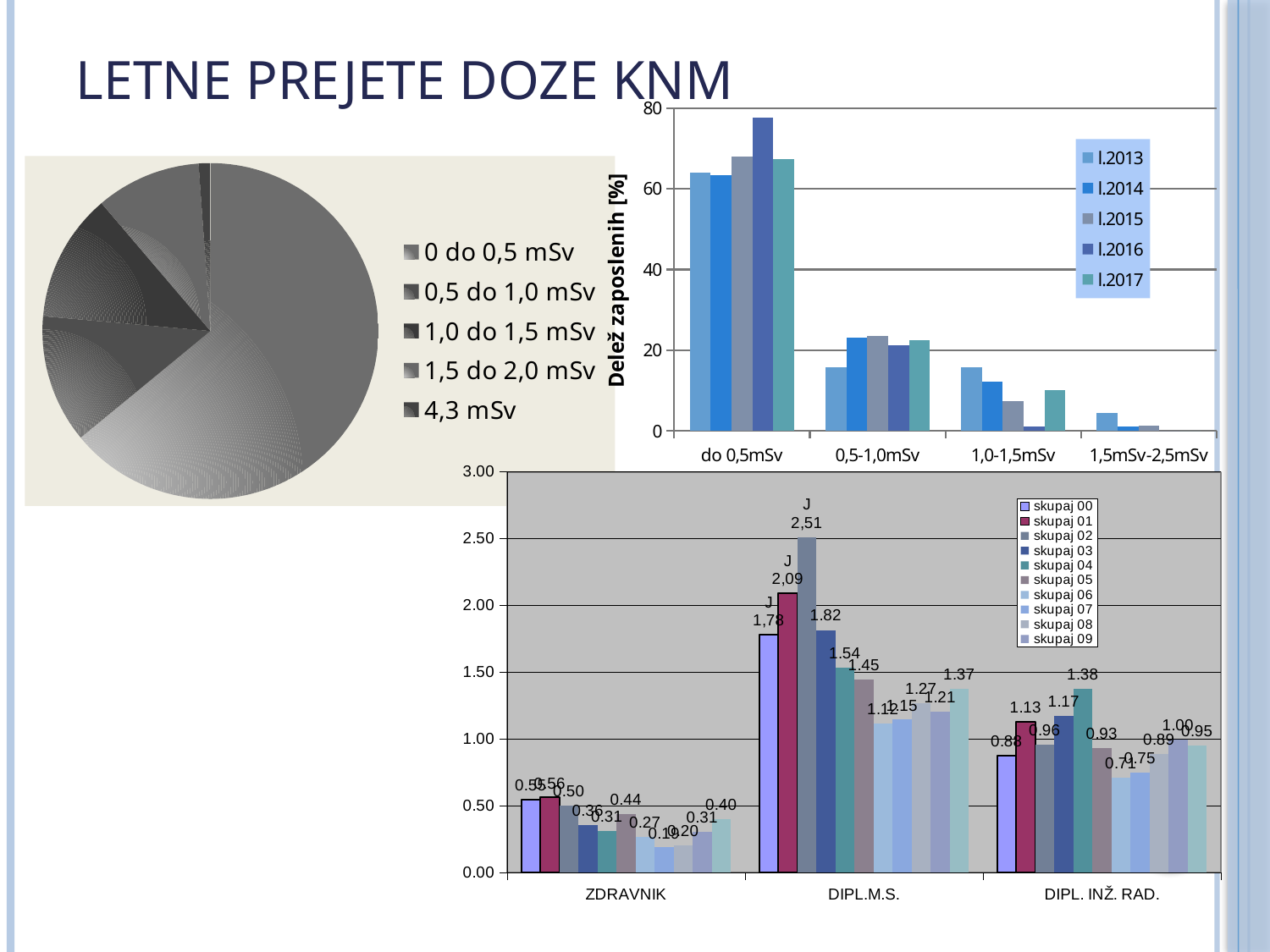
How many categories are shown on the x-axis of the top-right chart (Delež zaposlenih [%])? 4 In the top-right chart (Delež zaposlenih [%]), is the value for l.2016 in 'do 0,5mSv' greater or less than 60? greater In the pie chart on the left, which category has the largest slice? 0 do 0,5 mSv In the top-right chart (Delež zaposlenih [%]), which is larger for '1,0-1,5mSv': l.2016 or l.2017? l.2017 In the bottom chart, how many categories are shown on the x-axis? 3 What kind of chart is the top-right chart with the y-axis 'Delež zaposlenih [%]'? bar chart What kind of chart is the chart on the left of the slide? pie chart How many series does the legend of the top-right chart (Delež zaposlenih [%]) list? 5 In the bottom chart, what is the value for skupaj 02 in DIPL.M.S.? 2,51 In the top-right chart (Delež zaposlenih [%]), which year has the highest value for 'do 0,5mSv'? l.2016 In the top-right chart (Delež zaposlenih [%]), is the value for l.2013 in '0,5-1,0mSv' greater or less than 20? less How many entries does the legend of the pie chart on the left list? 5